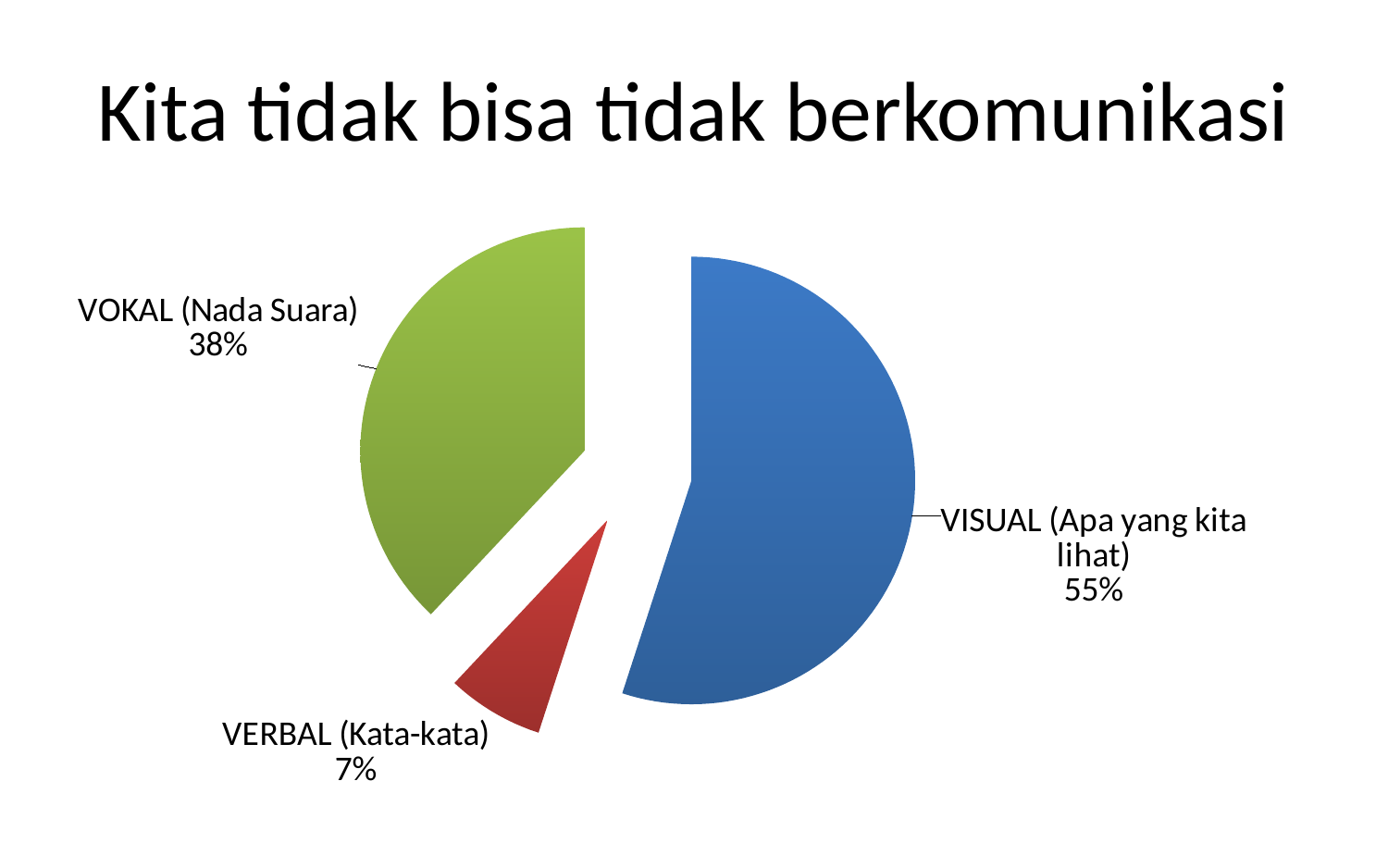
What is the title of the slide? Kita tidak bisa tidak berkomunikasi How many slices does the pie chart have? 3 What colour is the VISUAL (Apa yang kita lihat) slice? blue What is the difference in percentage points between VOKAL (Nada Suara) and VERBAL (Kata-kata)? 31 What kind of chart is shown on the slide? pie chart What share of the pie does VERBAL (Kata-kata) have? 7% What share of the pie does VOKAL (Nada Suara) have? 38% Which is larger, the share for VOKAL (Nada Suara) or the share for VERBAL (Kata-kata)? VOKAL (Nada Suara) Which slice of the pie is the largest? VISUAL (Apa yang kita lihat) Which slice of the pie is the smallest? VERBAL (Kata-kata) What is the difference in percentage points between VISUAL (Apa yang kita lihat) and VOKAL (Nada Suara)? 17 What share of the pie does VISUAL (Apa yang kita lihat) have? 55%